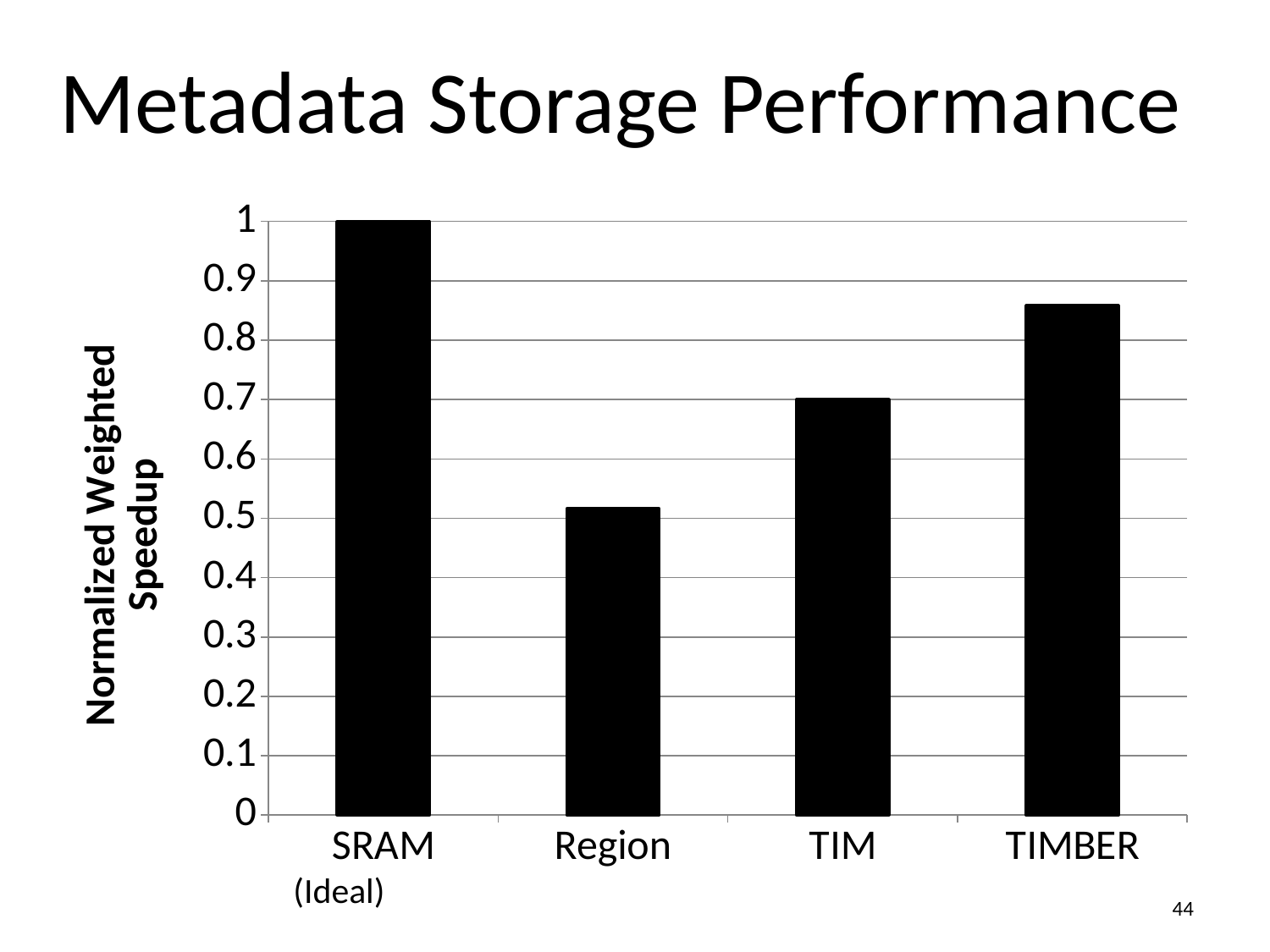
What is the label of the y axis? Normalized Weighted Speedup Is the value for TIMBER greater or less than 0.9? less Is the value for TIM greater or less than 0.6? greater Which category has the highest Normalized Weighted Speedup? SRAM (Ideal) Which category has the lowest Normalized Weighted Speedup? Region Which has a higher Normalized Weighted Speedup, Region or TIM? TIM What is the Normalized Weighted Speedup for SRAM (Ideal)? 1 Is the value for TIMBER greater or less than 0.8? greater How many categories are shown on the x axis of the chart? 4 Which has a higher Normalized Weighted Speedup, TIM or TIMBER? TIMBER What kind of chart is shown on the slide? bar chart